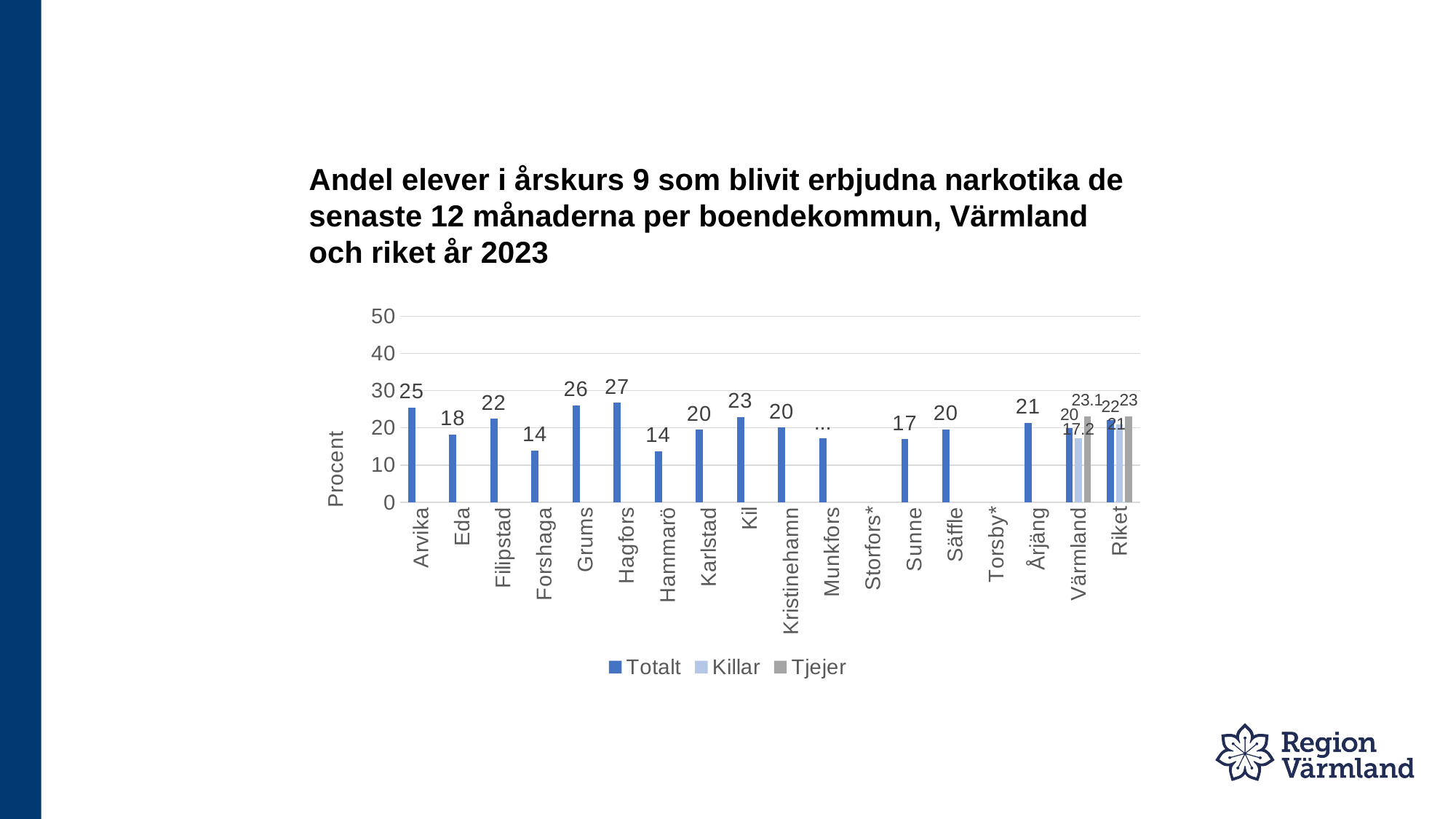
What is the Totalt value for Arvika? 25 What is the difference between the Tjejer and Killar values for Värmland? 5.9 What is the Totalt value for Hagfors? 27 What kind of chart is shown on the slide? Bar chart What is the label on the vertical axis? Procent Is the Totalt value for Forshaga greater or less than 20? less Which has a larger Totalt value, Grums or Kil? Grums What is the difference between the Totalt values for Hagfors and Eda? 9 What is the Tjejer value for Riket? 23 How many series does the legend list? 3 Which municipality has the highest Totalt value? Hagfors What is the Killar value for Värmland? 17.2